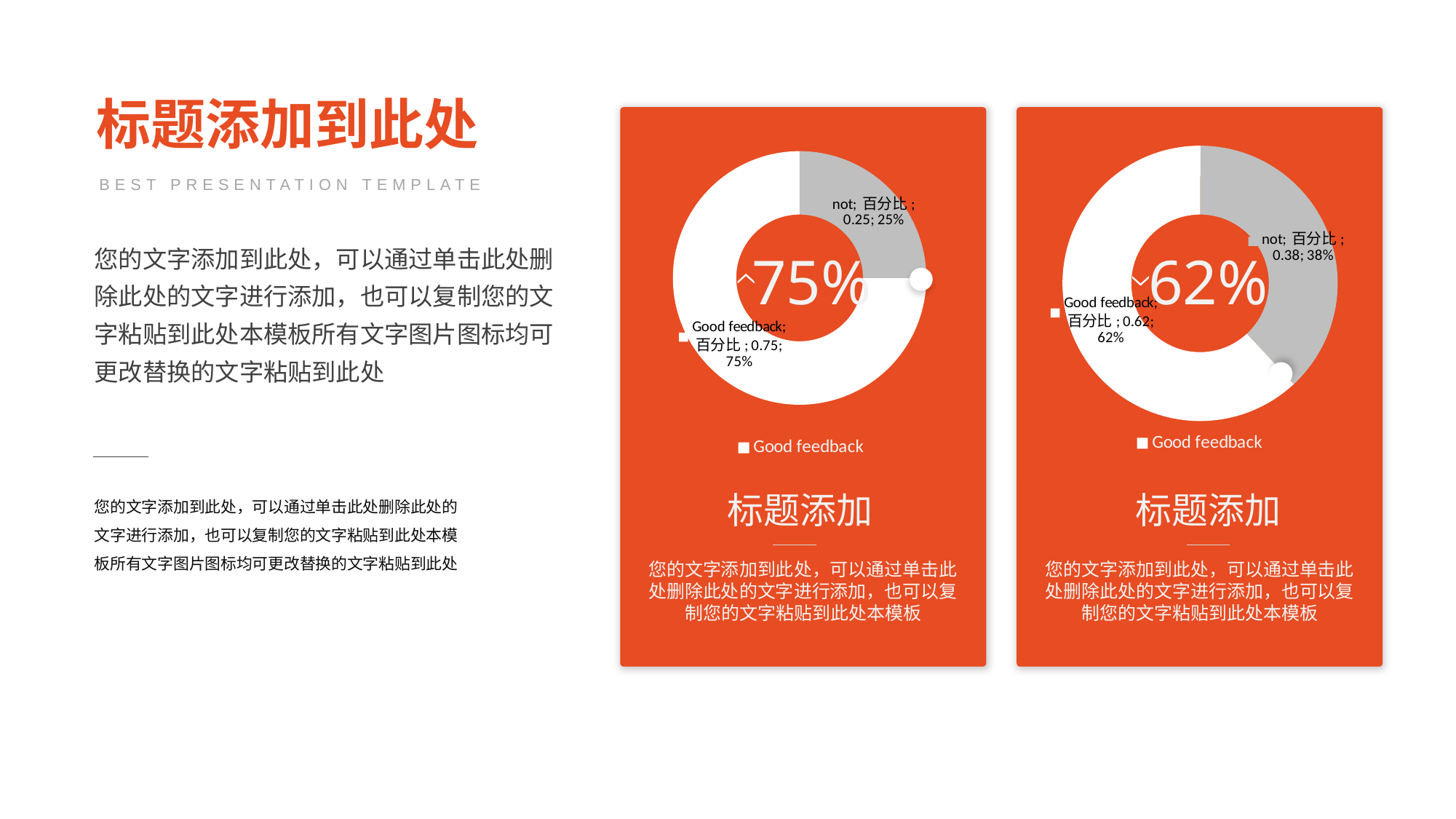
In the left doughnut chart, which slice is the largest? Good feedback Which chart has the larger 'not' slice, the left one or the right one? the right one In the right doughnut chart, what share does the 'Good feedback' slice have? 62% How many slices does the left doughnut chart have? 2 What kind of chart is shown on the right card? doughnut (pie) chart In the left doughnut chart, what value is printed for the 'not' slice? 0.25 In the right doughnut chart, what share does the 'not' slice have? 38% In the right doughnut chart, which slice is the smallest? not In the right doughnut chart, what value is printed for the 'Good feedback' slice? 0.62 In the left doughnut chart, what share does the 'Good feedback' slice have? 75% In the right doughnut chart, what is the difference in percentage points between the 'Good feedback' and 'not' slices? 24%